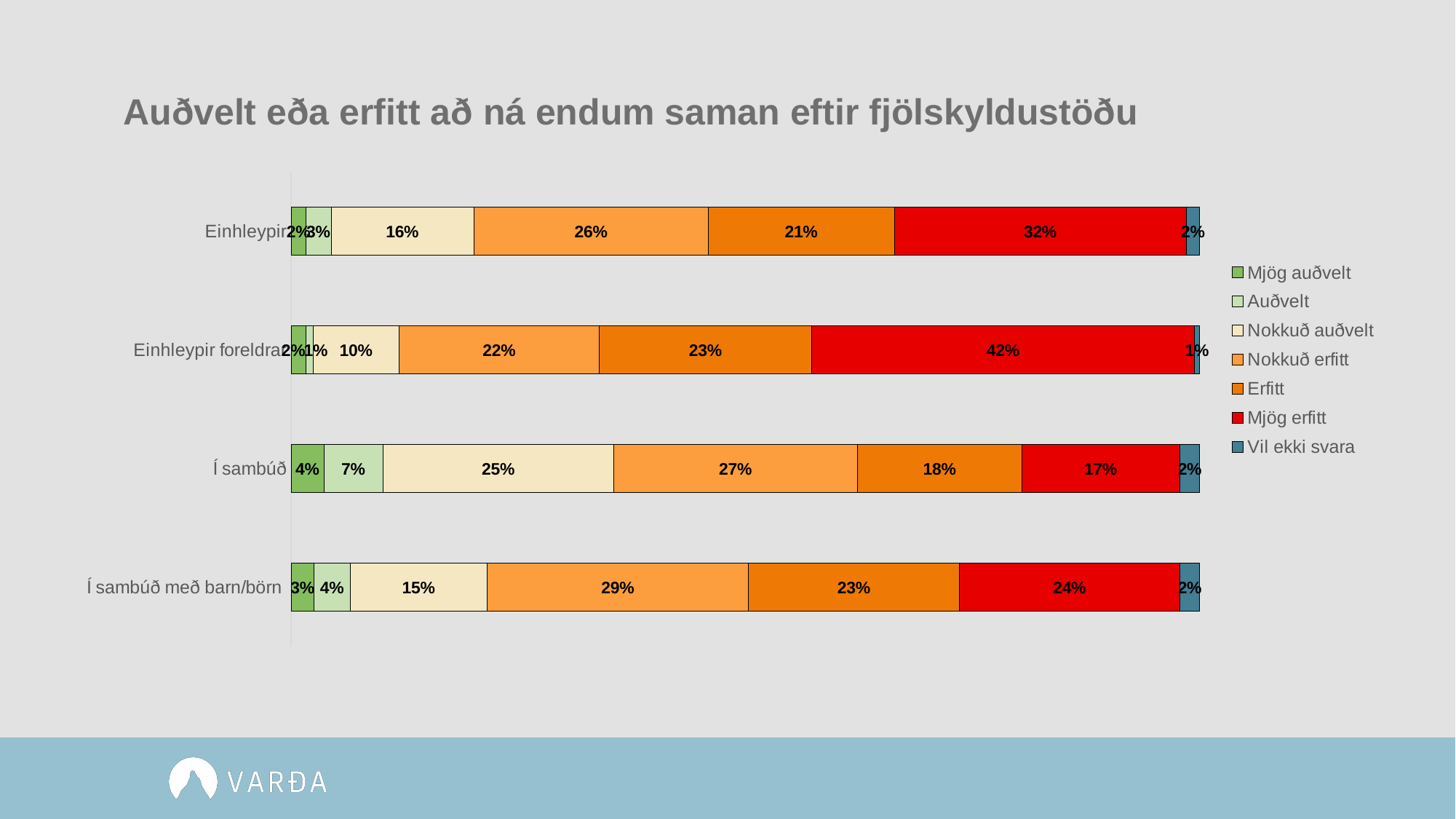
What is the 'Nokkuð auðvelt' value for 'Í sambúð'? 25% What type of chart is shown on the slide? Stacked bar chart What percentage of 'Einhleypir foreldrar' answered 'Mjög erfitt'? 42% Which has a larger 'Erfitt' value, 'Einhleypir foreldrar' or 'Einhleypir'? Einhleypir foreldrar Which response segment is the largest in the 'Í sambúð' bar? Nokkuð erfitt What is the 'Auðvelt' value for 'Í sambúð'? 7% How many series does the legend list? 7 Which family status category has the lowest 'Mjög erfitt' share? Í sambúð What is the 'Nokkuð erfitt' value for 'Í sambúð með barn/börn'? 29% How many family status categories are shown in the chart? 4 Which family status category has the highest 'Mjög erfitt' share? Einhleypir foreldrar What is the difference in percentage points between the 'Mjög erfitt' values for 'Einhleypir' and 'Í sambúð'? 15 percentage points